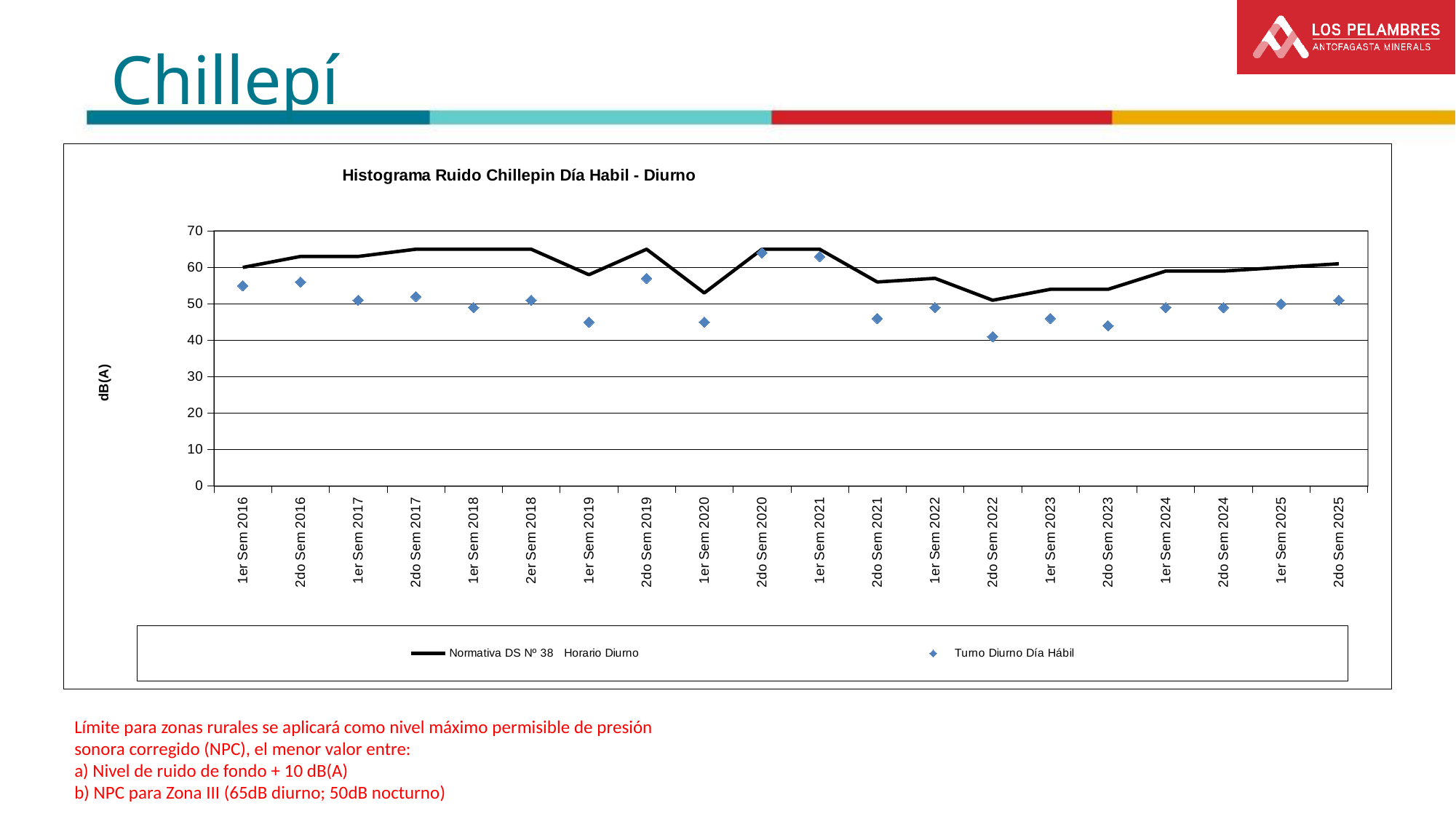
What type of chart is shown on the slide? Line chart How many series does the legend list? 2 Is the Turno Diurno Día Hábil value for 2do Sem 2020 greater or less than 60? greater Does the Turno Diurno Día Hábil series rise or fall from 2do Sem 2022 to 1er Sem 2025? rise What is the label of the y axis? dB(A) How many periods are shown on the x axis? 20 In which period is the Turno Diurno Día Hábil value lowest? 2do Sem 2022 Is the Normativa DS Nº 38 Horario Diurno value for 2do Sem 2017 greater or less than 60? greater Is the Turno Diurno Día Hábil value for 2do Sem 2022 greater or less than 50? less What is the title of the chart? Histograma Ruido Chillepin Día Habil - Diurno Which is larger, the Turno Diurno Día Hábil value for 1er Sem 2016 or for 1er Sem 2019? 1er Sem 2016